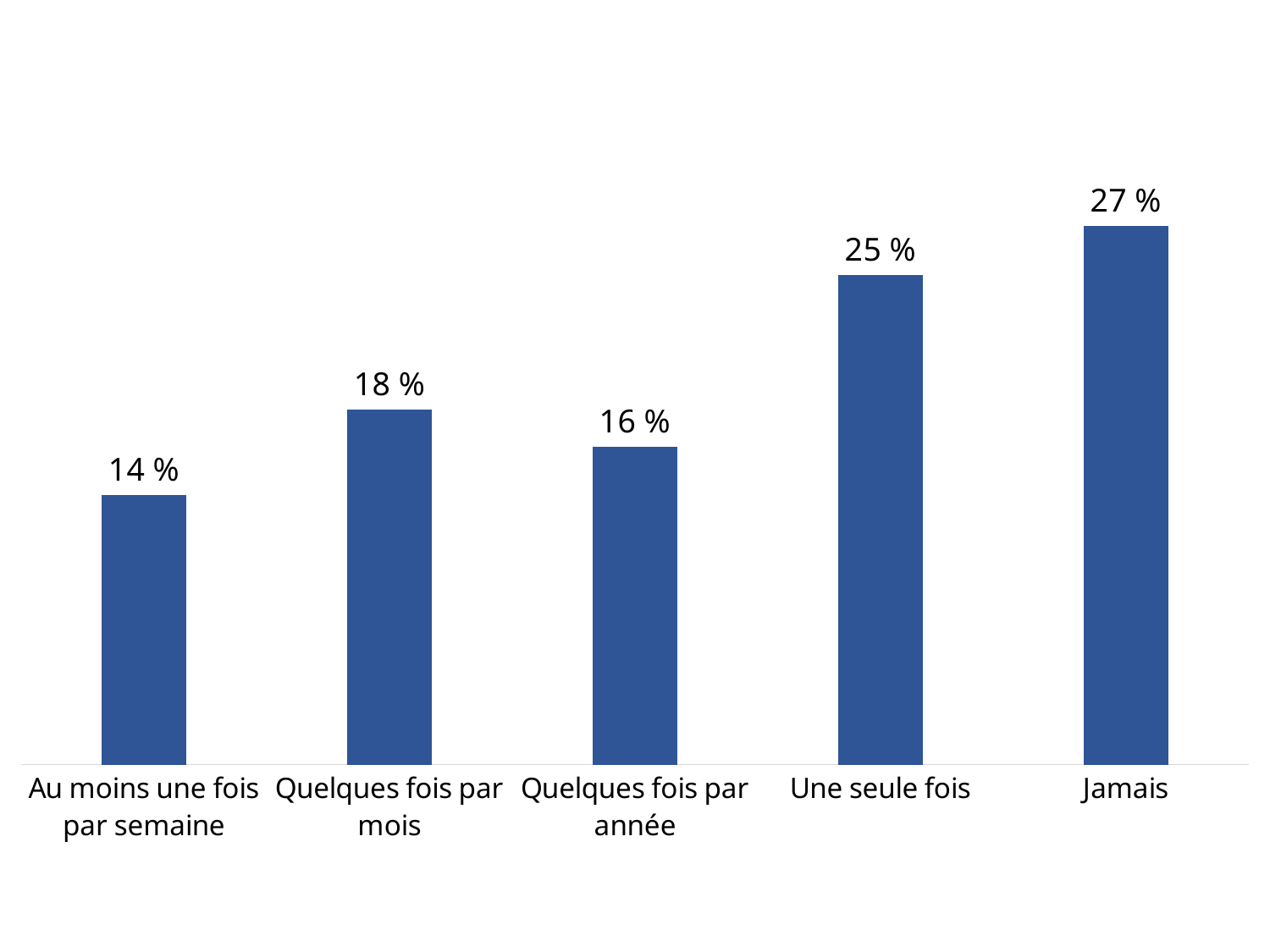
How many categories are shown on the x axis? 5 Which is larger, the value for "Quelques fois par mois" or the value for "Quelques fois par année"? Quelques fois par mois What colour are the bars in the chart? Blue What is the value for "Quelques fois par année"? 16 % What is the difference between the values for "Jamais" and "Une seule fois"? 2 % What kind of chart is shown on the slide? Bar chart What is the difference between the values for "Quelques fois par mois" and "Au moins une fois par semaine"? 4 % Which category has the lowest value? Au moins une fois par semaine What is the value for "Au moins une fois par semaine"? 14 % What is the value for "Jamais"? 27 % What is the value for "Une seule fois"? 25 % Which category has the highest value? Jamais